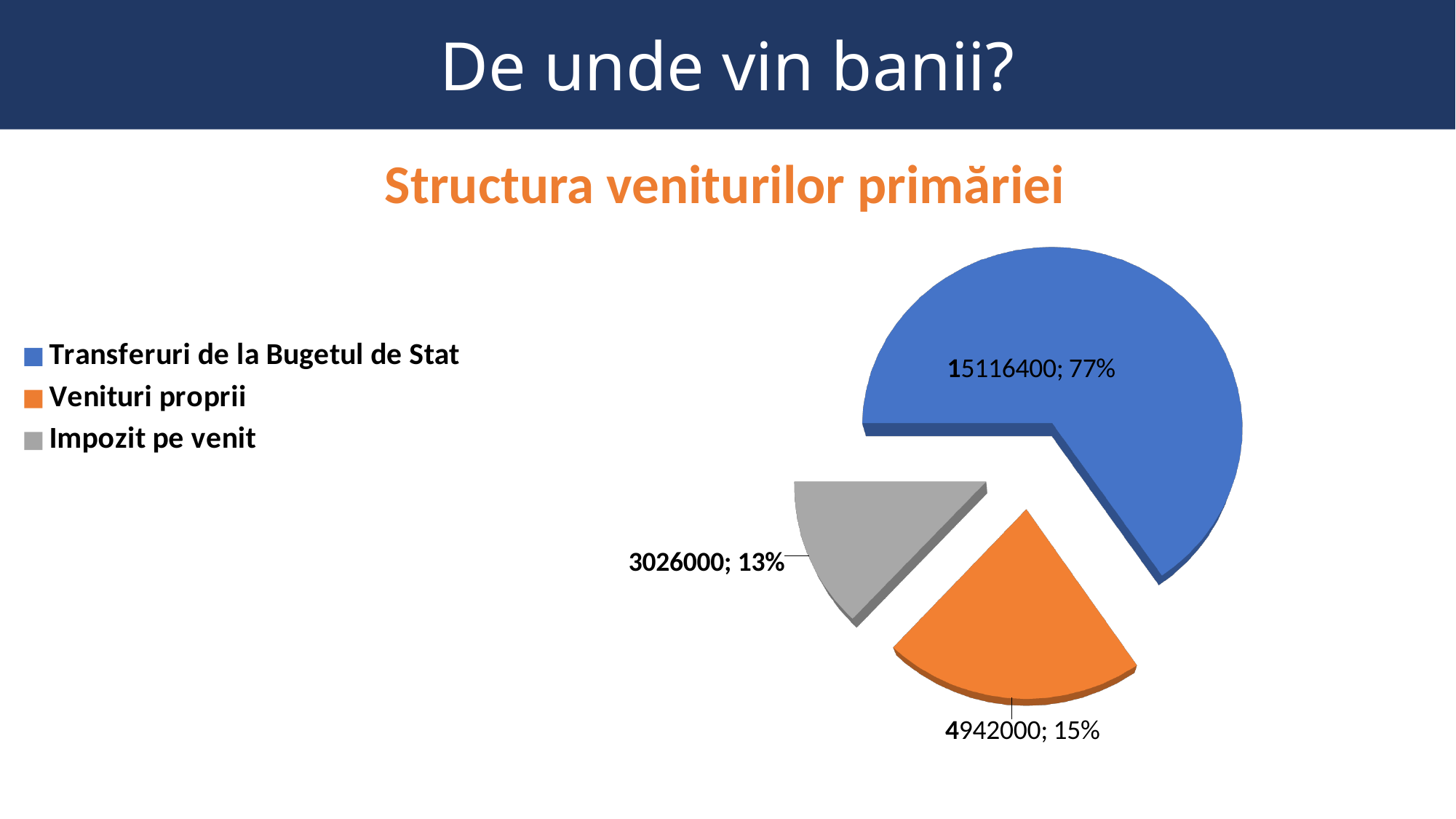
Which category has the smallest slice of the pie? Impozit pe venit What percentage share of the pie is labelled for Impozit pe venit? 13% What is the difference between the values for Venituri proprii and Impozit pe venit? 1916000 What is the title of the chart? Structura veniturilor primăriei What kind of chart is shown on the slide? Pie chart Which category has the largest slice of the pie? Transferuri de la Bugetul de Stat What value is shown for Transferuri de la Bugetul de Stat? 15116400 What value is shown for Impozit pe venit? 3026000 Which colour represents Venituri proprii in the legend? Orange What value is shown for Venituri proprii? 4942000 How many slices does the pie chart have? 3 What percentage share of the pie is labelled for Transferuri de la Bugetul de Stat? 77%